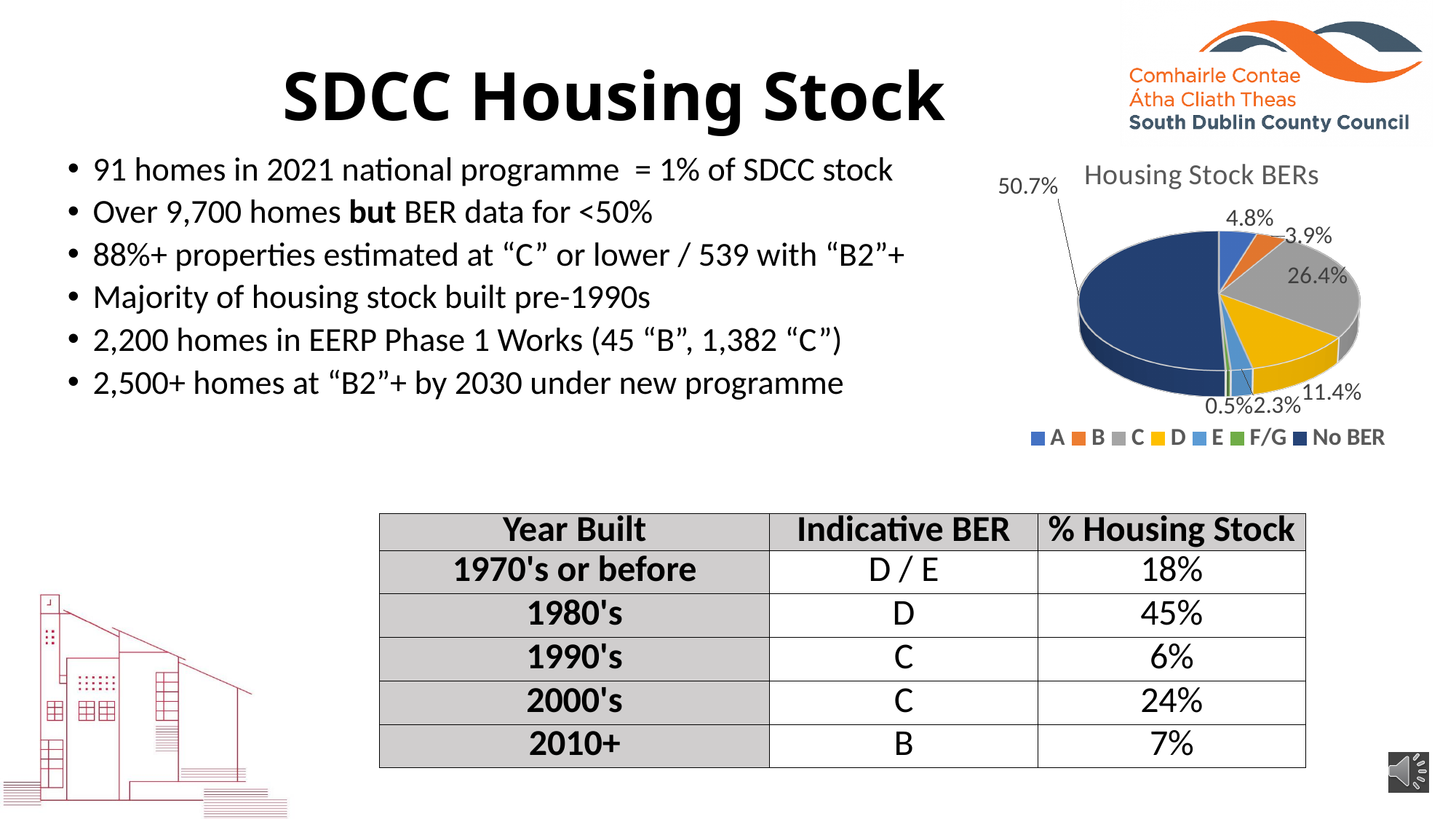
Which category has the smallest slice in the 'Housing Stock BERs' pie chart? F/G Which category has the largest slice in the 'Housing Stock BERs' pie chart? No BER What kind of chart is the 'Housing Stock BERs' chart? pie chart In the 'Housing Stock BERs' pie chart, what percentage of the housing stock is rated F/G? 0.5% In the 'Housing Stock BERs' pie chart, what share of the housing stock has no BER? 50.7% In the 'Housing Stock BERs' pie chart, what percentage of the housing stock is rated C? 26.4% In the 'Housing Stock BERs' pie chart, what percentage of the housing stock is rated D? 11.4% In the 'Housing Stock BERs' pie chart, what percentage of the housing stock is rated A? 4.8% How many categories does the legend of the 'Housing Stock BERs' pie chart list? 7 What is the title of the pie chart? Housing Stock BERs In the 'Housing Stock BERs' pie chart, which is larger: the share rated C or the share rated D? C In the 'Housing Stock BERs' pie chart, what is the difference between the share rated C and the share rated D? 15.0%